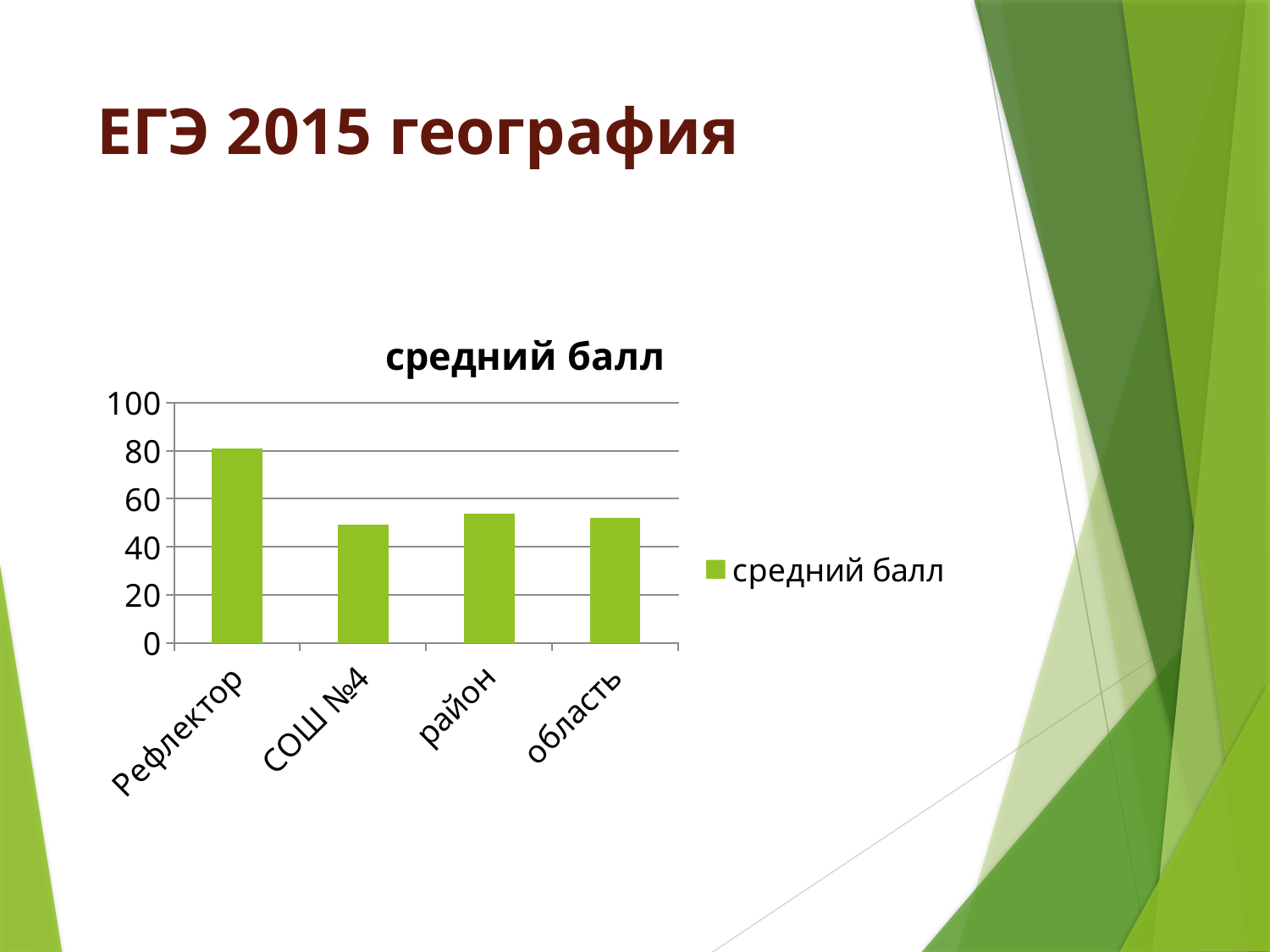
Is the value for Рефлектор greater or less than 60? greater Which category has the highest средний балл? Рефлектор How many series does the chart legend list? 1 Which is larger, the value for район or the value for СОШ №4? район Is the value for СОШ №4 greater or less than 60? less Is the value for район greater or less than 40? greater What is the name of the series shown in the chart legend? средний балл What kind of chart is shown on the slide? bar chart How many categories are shown on the x axis of the chart? 4 Which is larger, the value for Рефлектор or the value for район? Рефлектор What is the title of the chart? средний балл